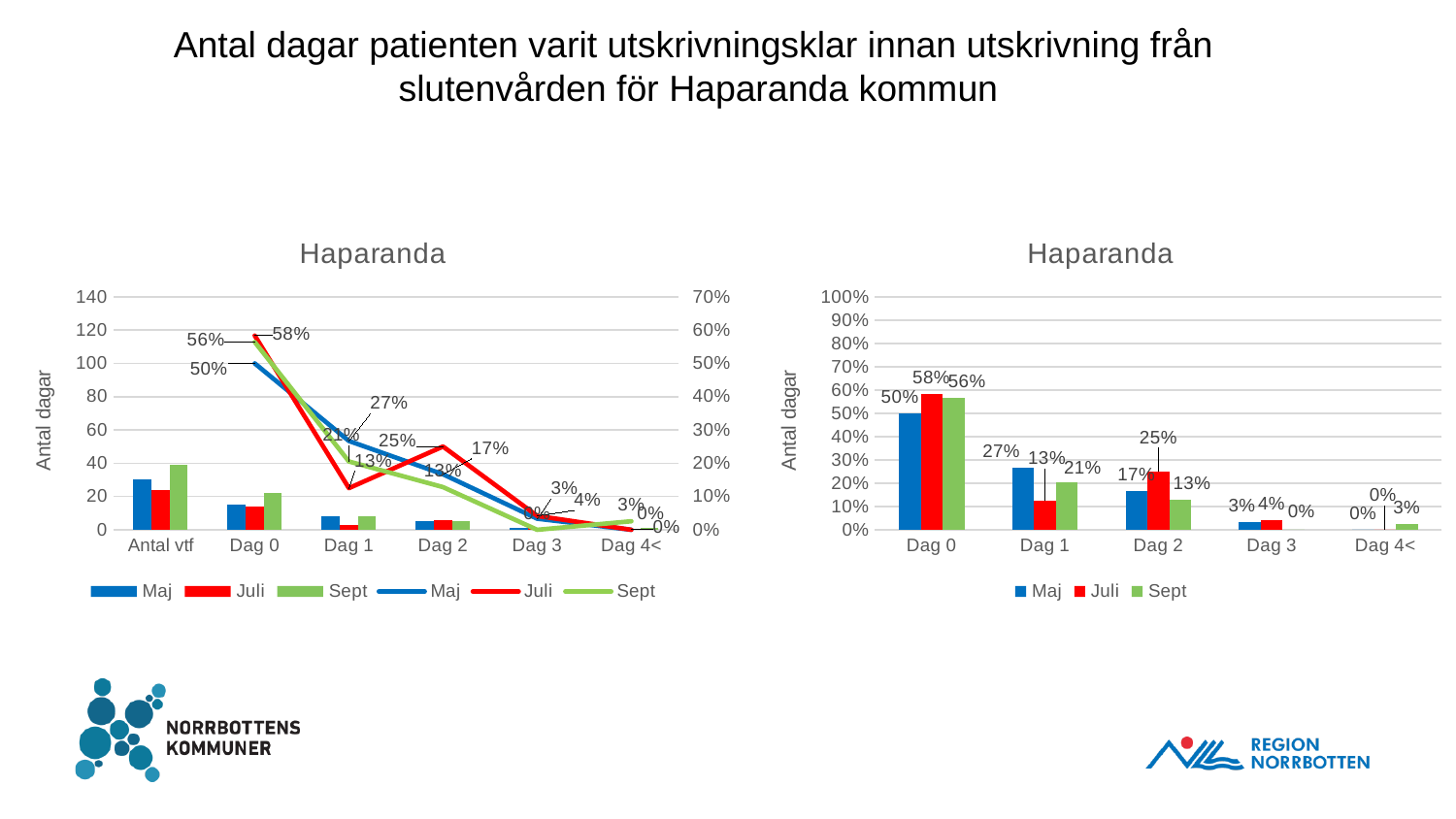
On the right-hand chart, is the value for Maj at Dag 0 larger or smaller than the value for Sept at Dag 0? smaller On the right-hand chart, what is the value for Sept at Dag 2? 13% On the right-hand chart, which series has the lowest value at Dag 1? Juli On the right-hand chart, which series has the highest value at Dag 2? Juli On the right-hand chart, do the Maj values rise or fall from Dag 0 to Dag 3? fall On the right-hand chart, how many series does the legend list? 3 On the right-hand chart, what is the difference between Juli and Maj at Dag 0? 8% On the right-hand chart, what is the value for Maj at Dag 1? 27% On the left-hand chart, is the Sept bar for Antal vtf greater or less than 20? greater On the right-hand chart, how many categories are shown on the x axis? 5 On the left-hand chart, how many entries does the legend list? 6 On the right-hand chart, what is the value for Juli at Dag 0? 58%